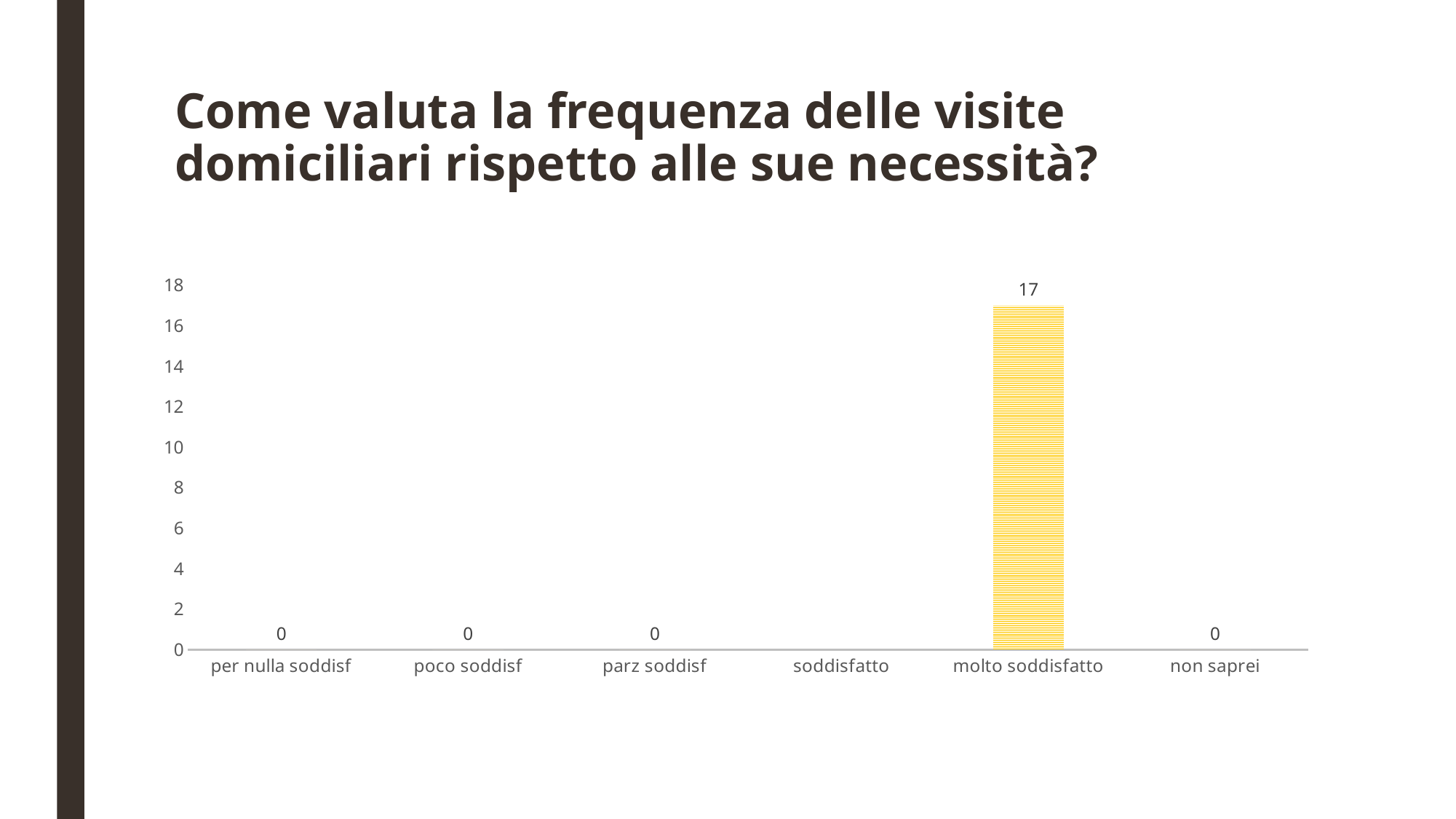
What is the title of the chart? Come valuta la frequenza delle visite domiciliari rispetto alle sue necessità? What is the highest value shown on the y axis? 18 What is the value for non saprei? 0 What is the value for per nulla soddisf? 0 What is the value for molto soddisfatto? 17 What is the value for poco soddisf? 0 Is the value for molto soddisfatto greater or less than 16? greater What is the difference between the values for molto soddisfatto and parz soddisf? 17 What kind of chart is shown on the slide? bar chart Which is larger, the value for molto soddisfatto or the value for non saprei? molto soddisfatto Which category has the highest value? molto soddisfatto How many categories are shown on the x axis? 6